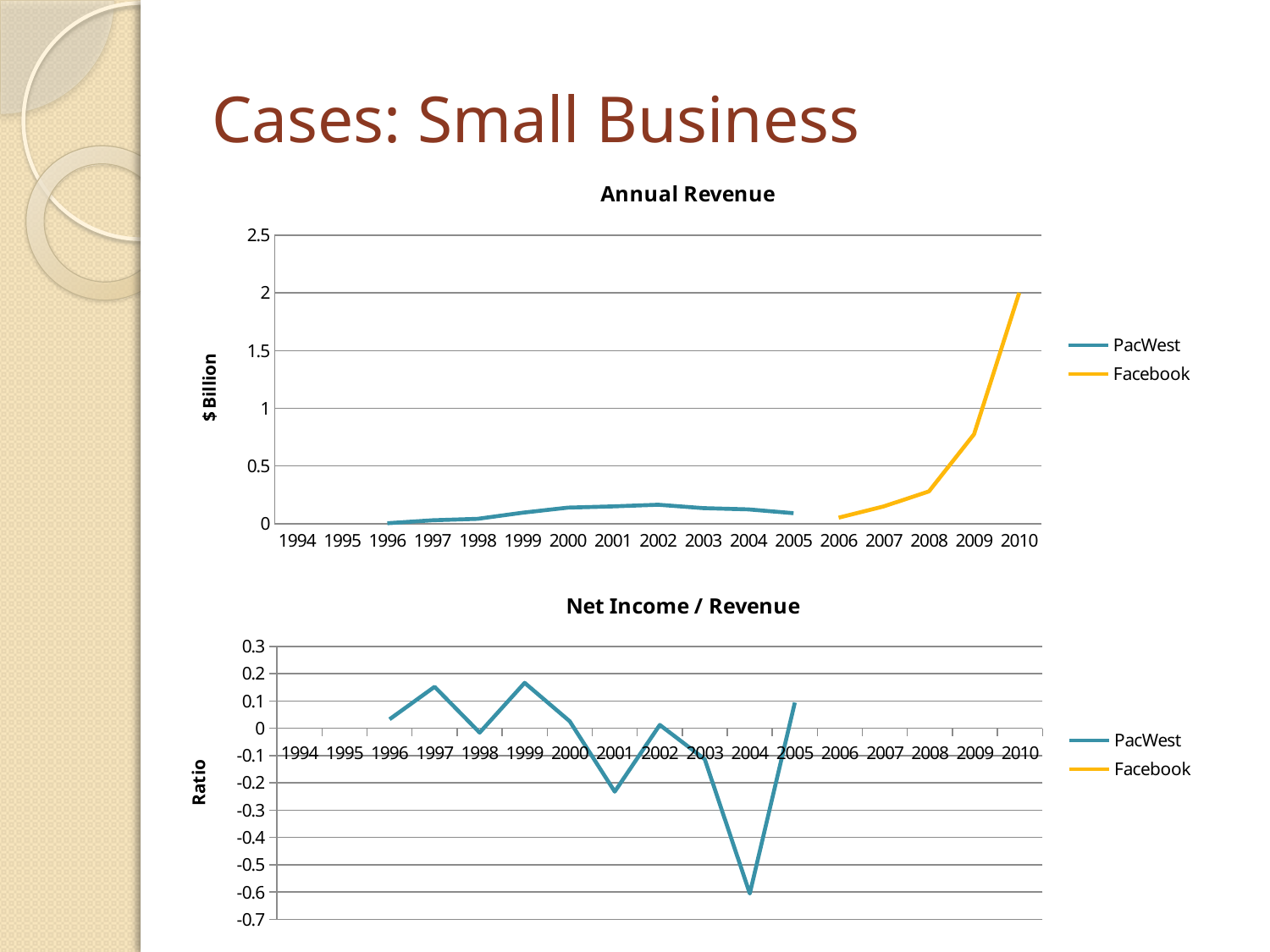
What is the y-axis label of the Annual Revenue chart? $ Billion In the Net Income / Revenue chart, is the PacWest value for 2004 greater or less than -0.5? less In the Annual Revenue chart, is the Facebook value for 2010 greater or less than 1.5? greater In the Annual Revenue chart, does Facebook's revenue rise or fall from 2006 to 2010? rise In the Annual Revenue chart, is the Facebook value for 2009 greater or less than 1? less What kind of chart is the Annual Revenue chart? line chart In the Annual Revenue chart, in which year is Facebook's revenue highest? 2010 In the Net Income / Revenue chart, in which year is the PacWest ratio lowest? 2004 How many series does the legend of the Annual Revenue chart list? 2 How many years are shown on the x axis of the Annual Revenue chart? 17 In the Net Income / Revenue chart, which year has the larger PacWest ratio, 1997 or 1998? 1997